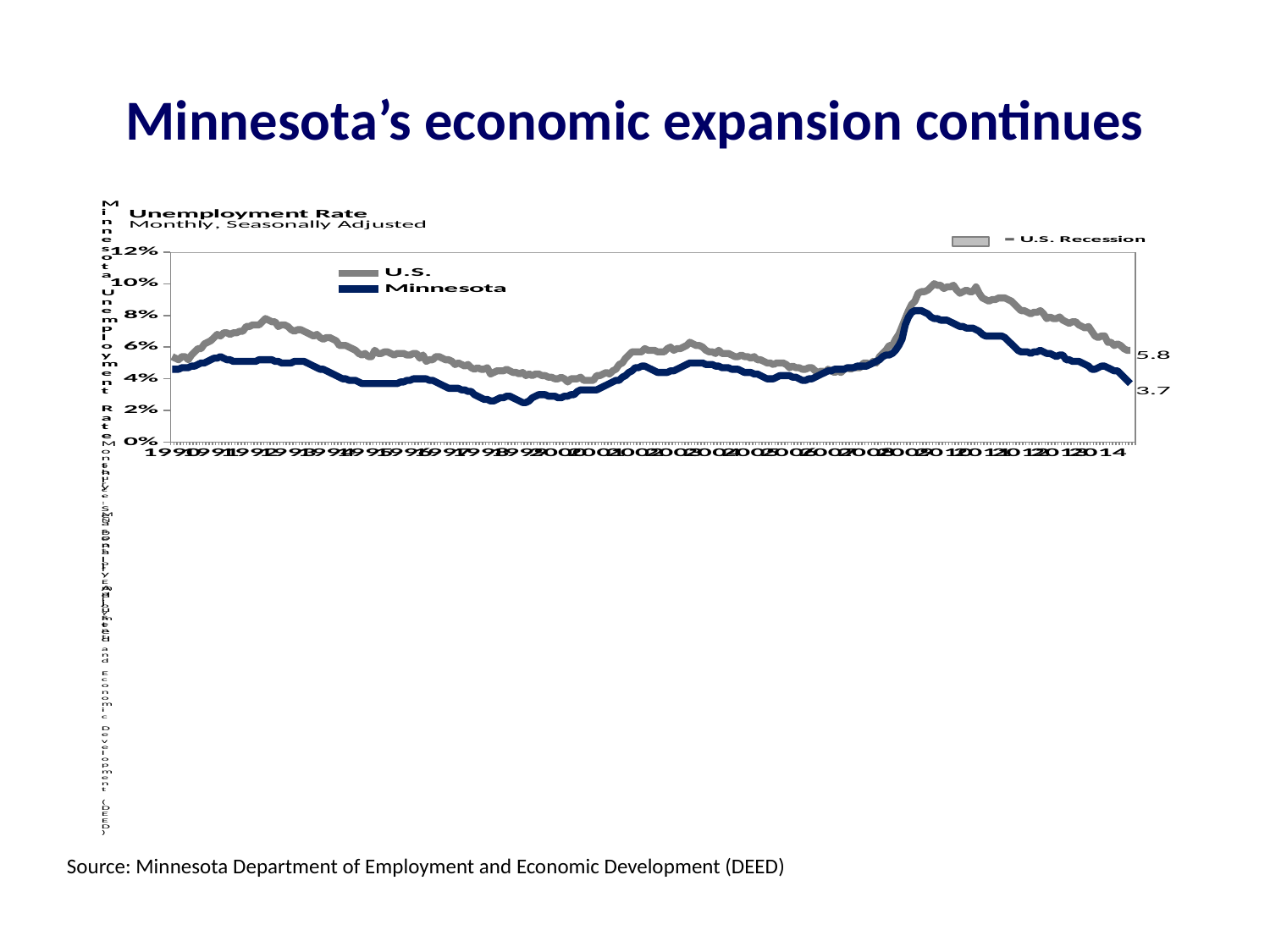
What is the title of the chart? Unemployment Rate How many data series (lines) does the chart's legend list? 2 Does the U.S. line rise or fall between 2010 and 2014? fall What is the final labelled value of the U.S. unemployment rate line? 5.8 At the end of the series, which line has the higher value, U.S. or Minnesota? U.S. What kind of chart is shown on the slide? line chart Is the peak of the U.S. line around 2009-2010 greater or less than 8%? greater What is the final labelled value of the Minnesota unemployment rate line? 3.7 Is the Minnesota line around 1999 greater or less than 4%? less What is the difference between the final labelled U.S. value and the final labelled Minnesota value? 2.1 Which series is plotted in dark blue (navy)? Minnesota What is the first year shown on the x axis? 1990